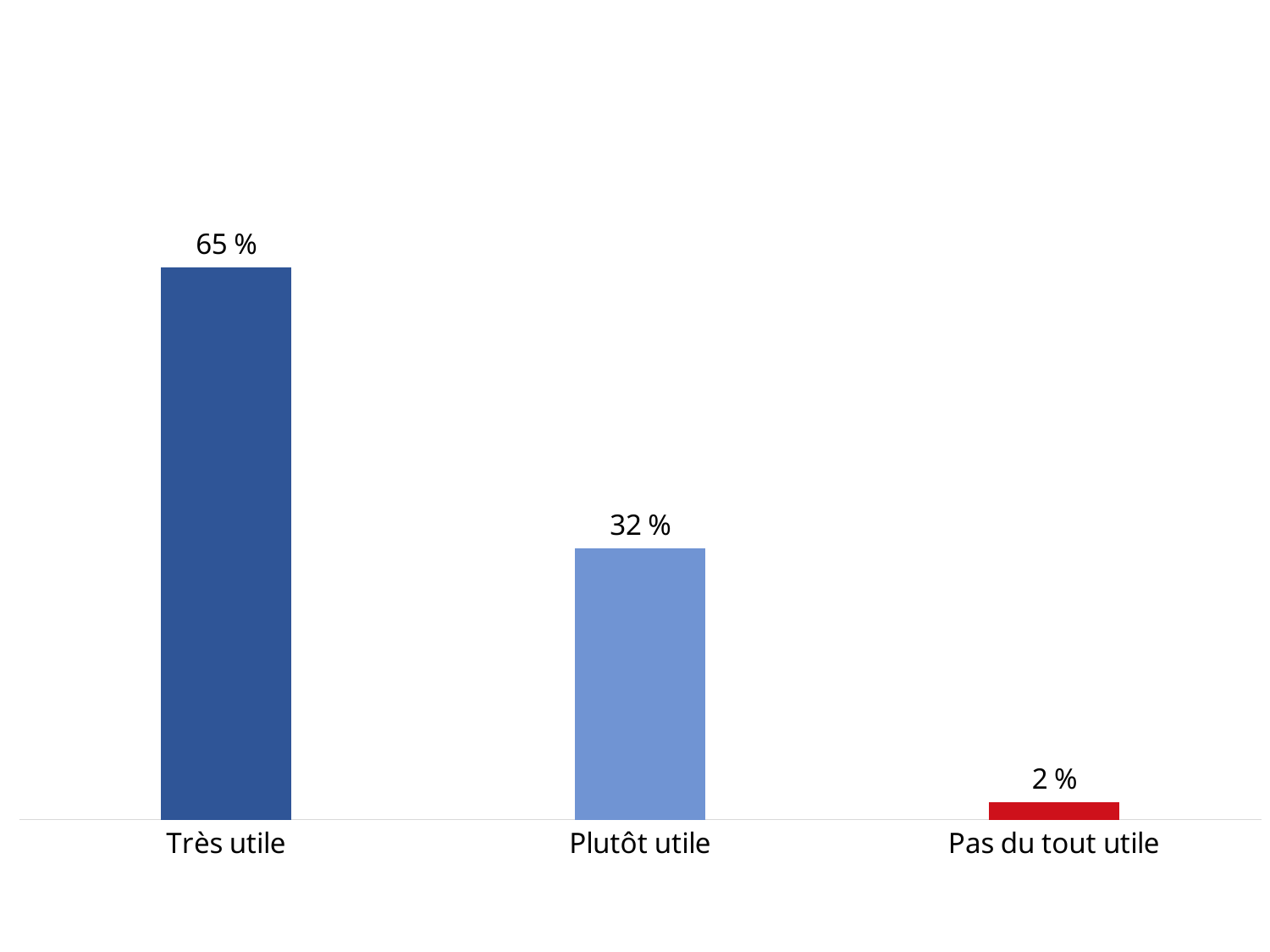
What is the value for Pas du tout utile? 2 % How many categories are shown in the chart? 3 What is the value for Plutôt utile? 32 % What is the difference between the values for Très utile and Plutôt utile? 33 % What colour is the bar for Pas du tout utile? Red What is the value for Très utile? 65 % Do the values rise or fall from left to right across the categories? Fall What kind of chart is shown on the slide? Bar chart What is the difference between the values for Plutôt utile and Pas du tout utile? 30 % Which category has the highest value? Très utile Which is larger, the value for Plutôt utile or the value for Pas du tout utile? Plutôt utile Which category has the lowest value? Pas du tout utile